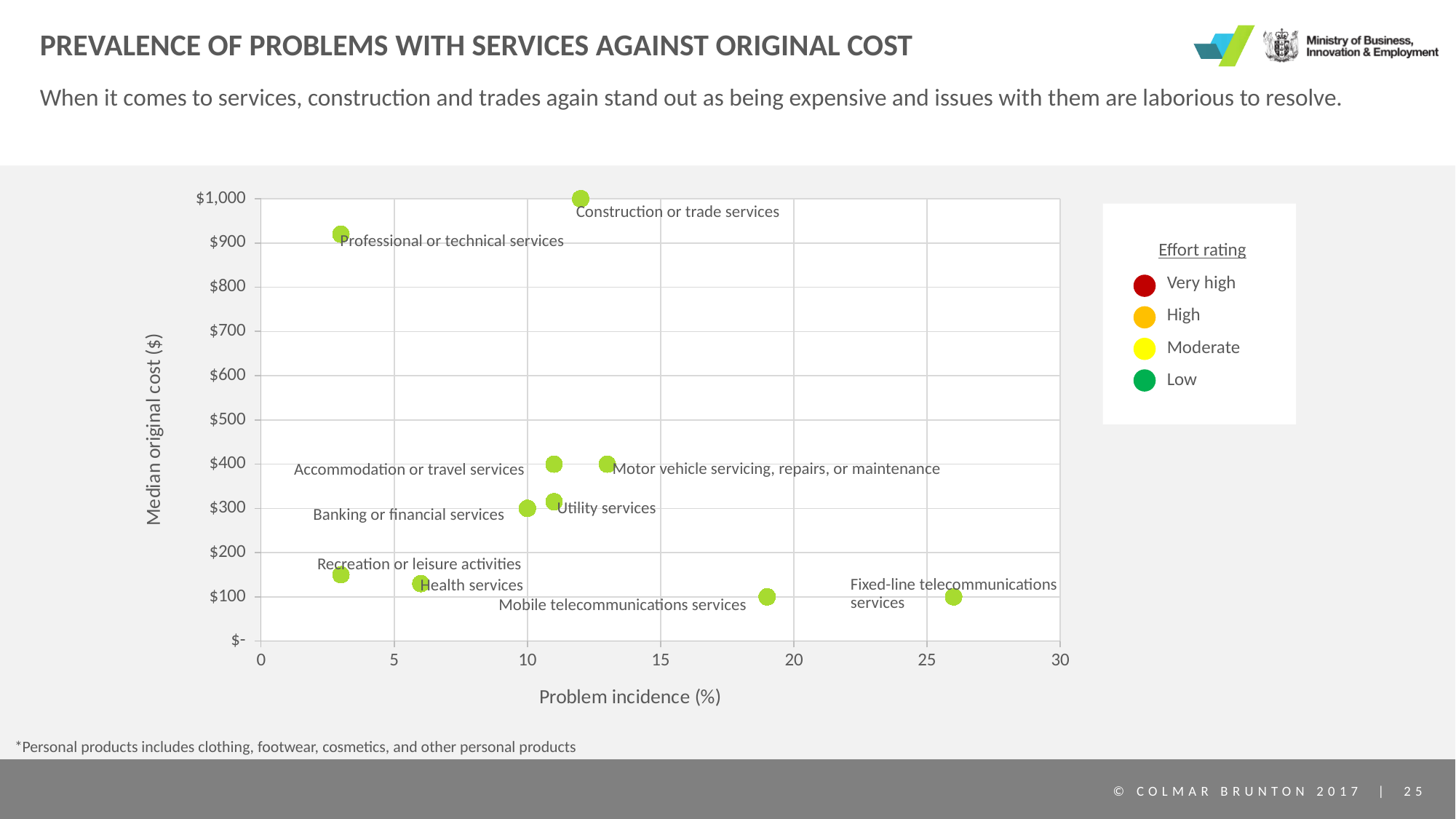
What is the median original cost for Construction or trade services? $1,000 What is the median original cost for Accommodation or travel services? $400 What is the problem incidence for Banking or financial services? 10% Which service category has the highest problem incidence? Fixed-line telecommunications services Which service category has the highest median original cost? Construction or trade services Is the median original cost for Health services greater or less than $200? less Which has a higher median original cost: Professional or technical services or Motor vehicle servicing, repairs, or maintenance? Professional or technical services How many service categories are plotted on the chart? 10 What is the label of the x axis? Problem incidence (%) How many effort rating levels does the legend list? 4 What kind of chart is shown on the slide? Scatter chart Is the median original cost for Professional or technical services greater or less than $800? greater